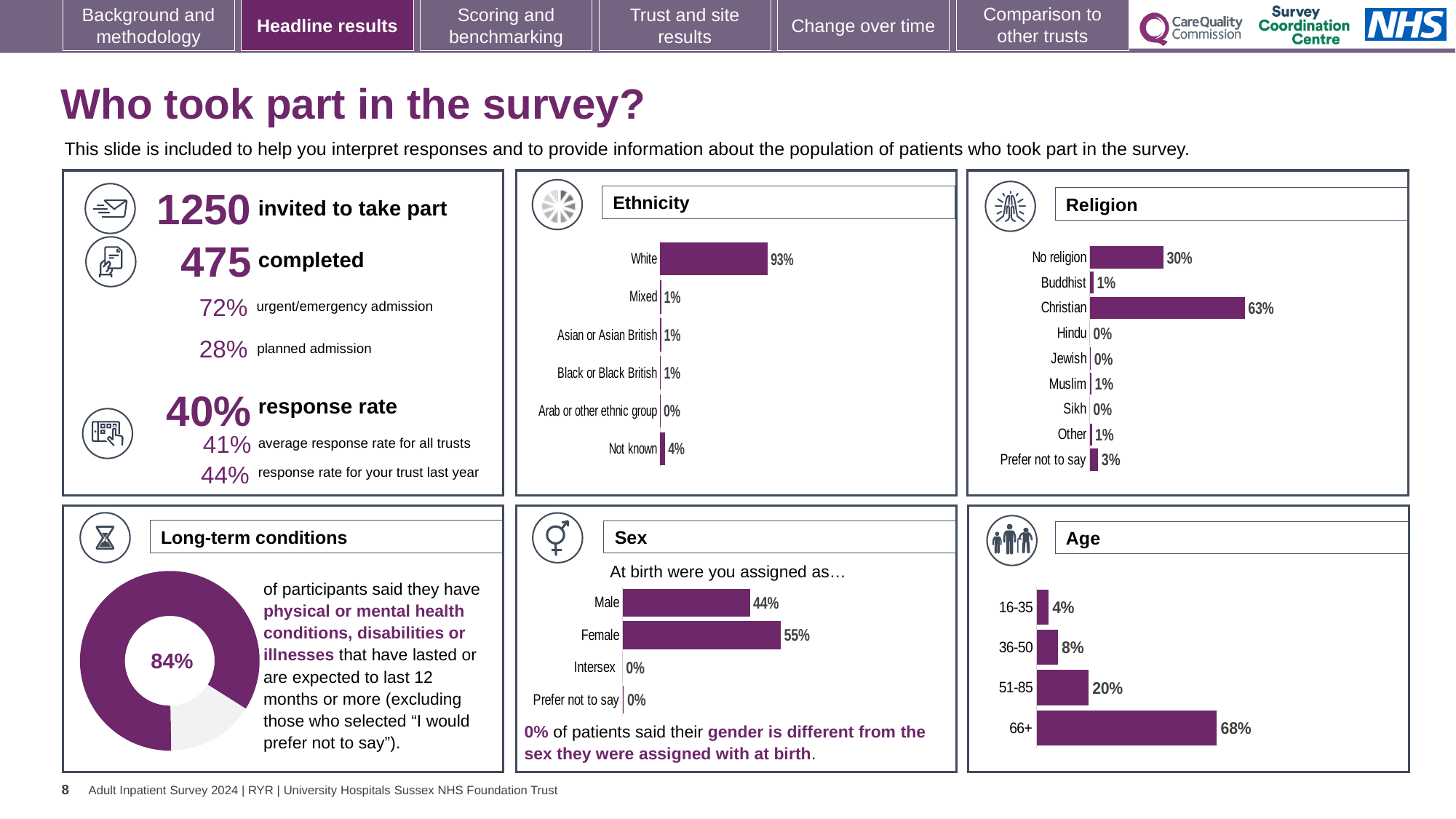
In the Age chart, which age group has the lowest value? 16-35 In the Sex chart, what is the difference between Female and Male? 11% In the Age chart, what percentage of respondents were aged 66+? 68% In the Ethnicity chart, what percentage of respondents were White? 93% In the Sex chart, which is larger, Male or Female? Female In the Long-term conditions chart, what share of participants said they have long-term conditions? 84% In the Religion chart, what is the difference between Christian and No religion? 33% In the Ethnicity chart, which category has the highest value? White In the Religion chart, what percentage of respondents were Christian? 63% In the Ethnicity chart, what is the value for Not known? 4% What kind of chart is the Age chart? Bar chart In the Religion chart, how many categories are shown? 9